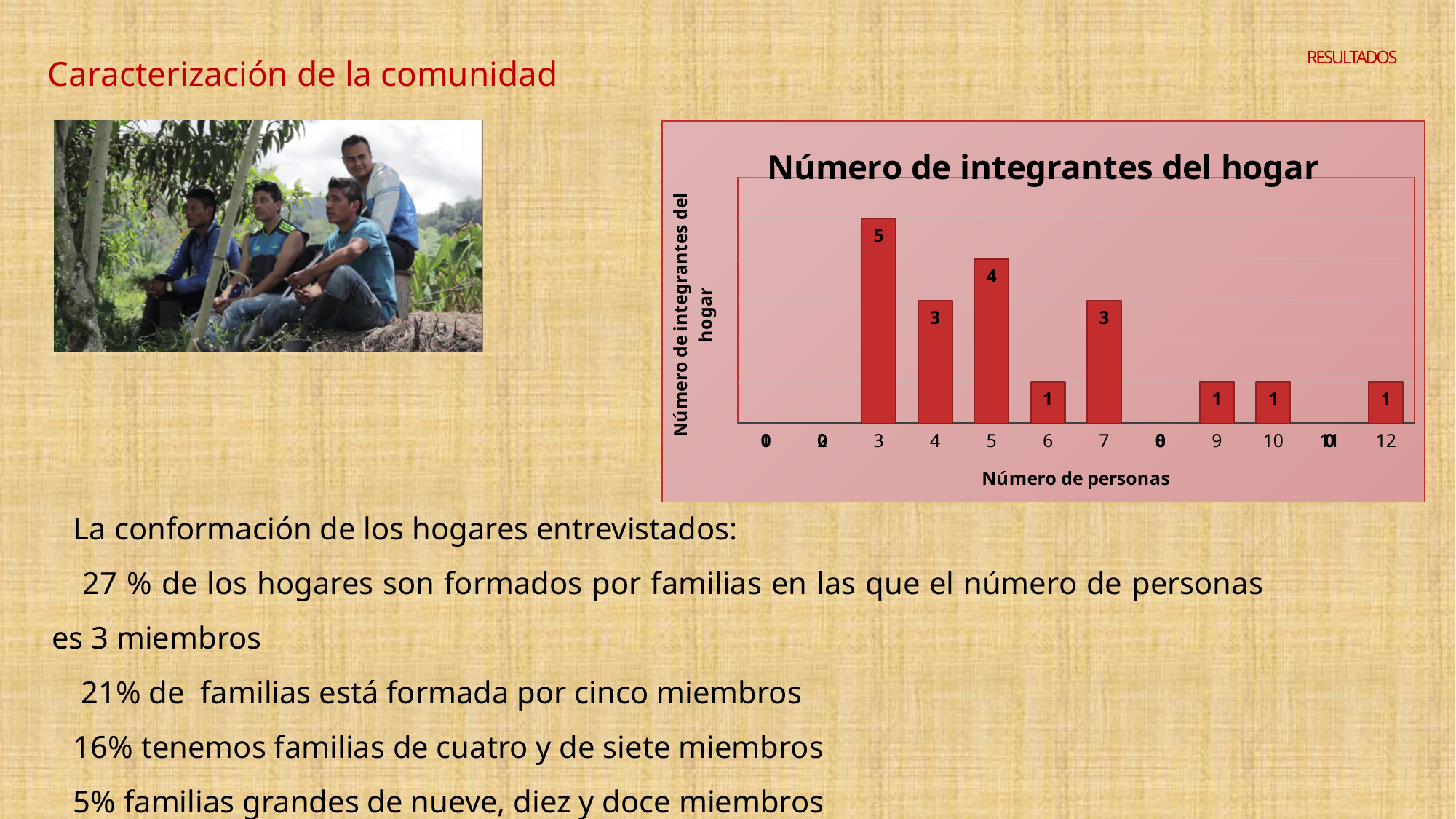
What is the value for 3 personas in the 'Número de integrantes del hogar' chart? 5 Which has a larger value, 5 personas or 7 personas? 5 personas What is the value for 4 personas in the chart? 3 How many categories on the x axis have a value of 1? 4 What kind of chart is shown on the slide? Bar chart What is the value for 5 personas in the chart? 4 Which number of personas has the highest bar in the chart? 3 What is the title of the chart? Número de integrantes del hogar What is the difference between the values for 3 personas and 6 personas? 4 What is the value for 7 personas in the chart? 3 What is the difference between the values for 3 personas and 5 personas? 1 What is the title of the x axis of the chart? Número de personas